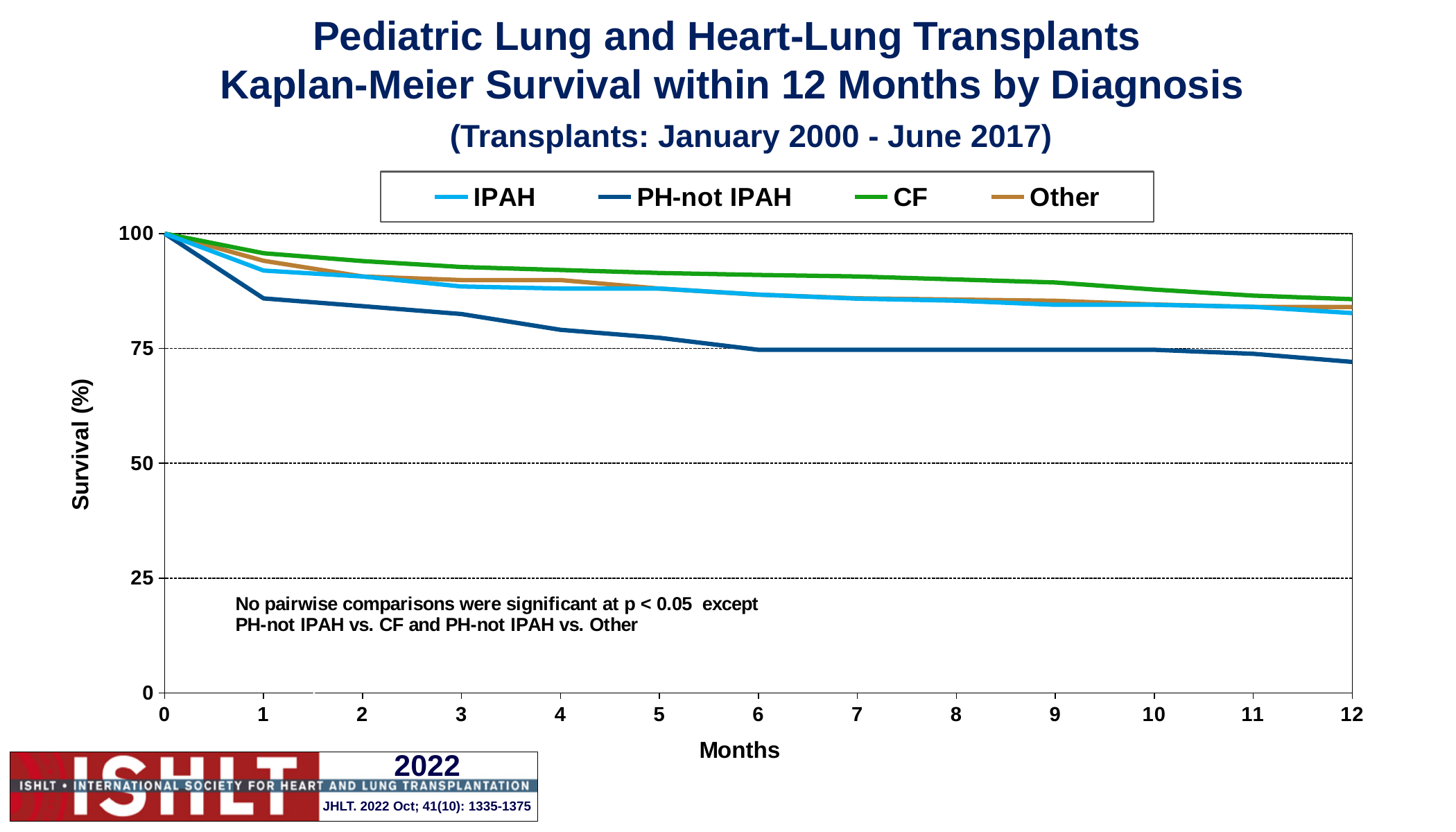
How many series does the legend list? 4 Is the survival value for PH-not IPAH at 12 months greater or less than 75? less Which diagnosis group has the highest survival at month 6? CF What is the label of the y axis? Survival (%) Do the survival curves rise or fall as months increase? fall Which series is drawn in green? CF What kind of chart is shown on the slide? line chart Is the survival value for CF at 12 months greater or less than 75? greater Which diagnosis group has the lowest survival at 12 months? PH-not IPAH What is the survival value for all diagnosis groups at month 0? 100 At month 3, which is larger: the survival for CF or for PH-not IPAH? CF Is the survival value for PH-not IPAH at month 1 greater or less than 75? greater